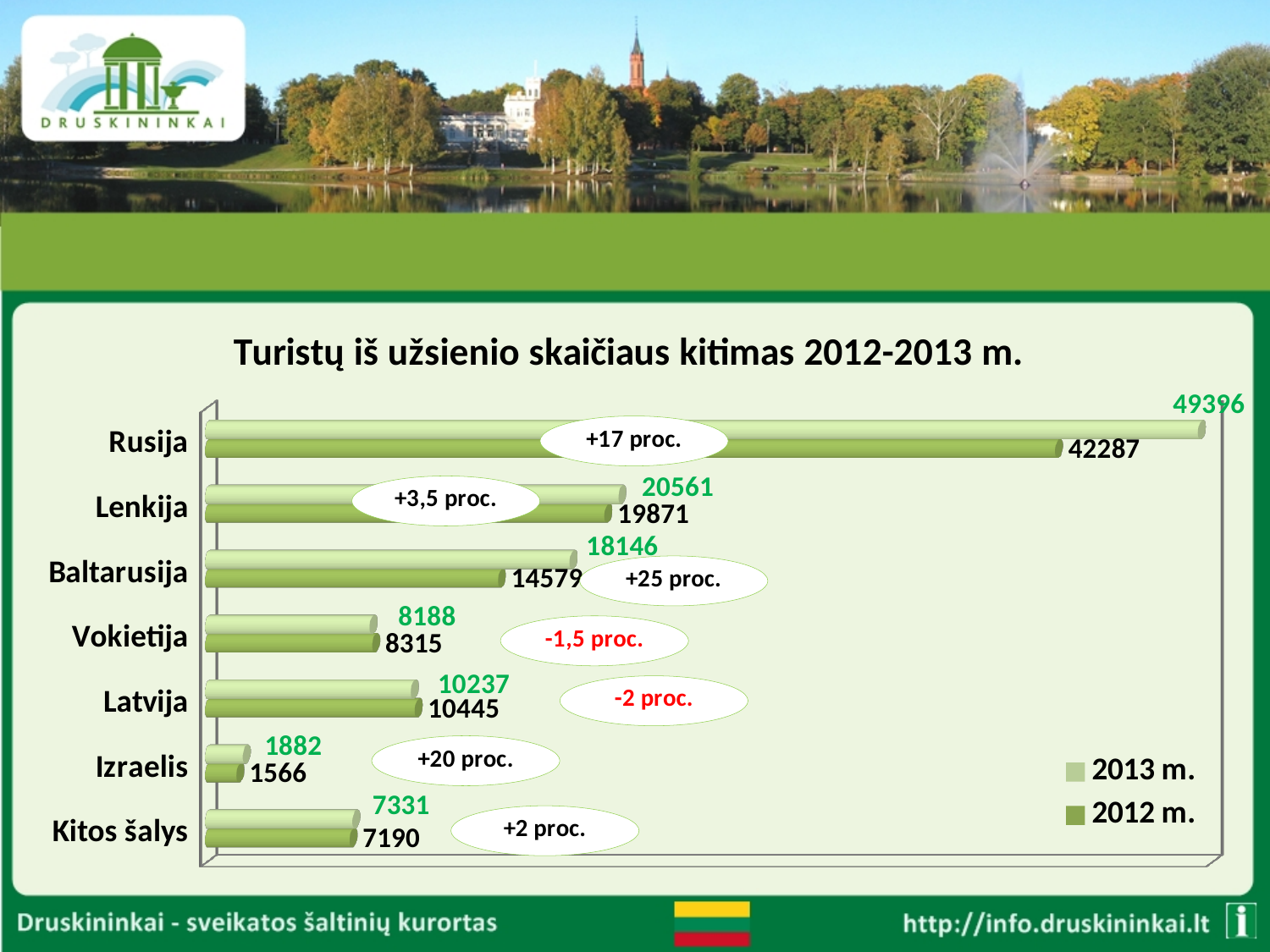
What is the value for Baltarusija in the 2013 m. series? 18146 How many categories are shown on the chart? 7 How many series does the legend list? 2 What is the difference between the 2013 m. and 2012 m. values for Baltarusija? 3567 What is the value for Rusija in the 2013 m. series? 49396 What is the value for Izraelis in the 2012 m. series? 1566 What is the value for Lenkija in the 2012 m. series? 19871 Which category has the lowest value in the 2012 m. series? Izraelis What kind of chart is shown on the slide? bar chart Which category has the highest value in the 2013 m. series? Rusija Which is larger for Vokietija: the 2013 m. value or the 2012 m. value? 2012 m. What is the title of the chart? Turistų iš užsienio skaičiaus kitimas 2012-2013 m.